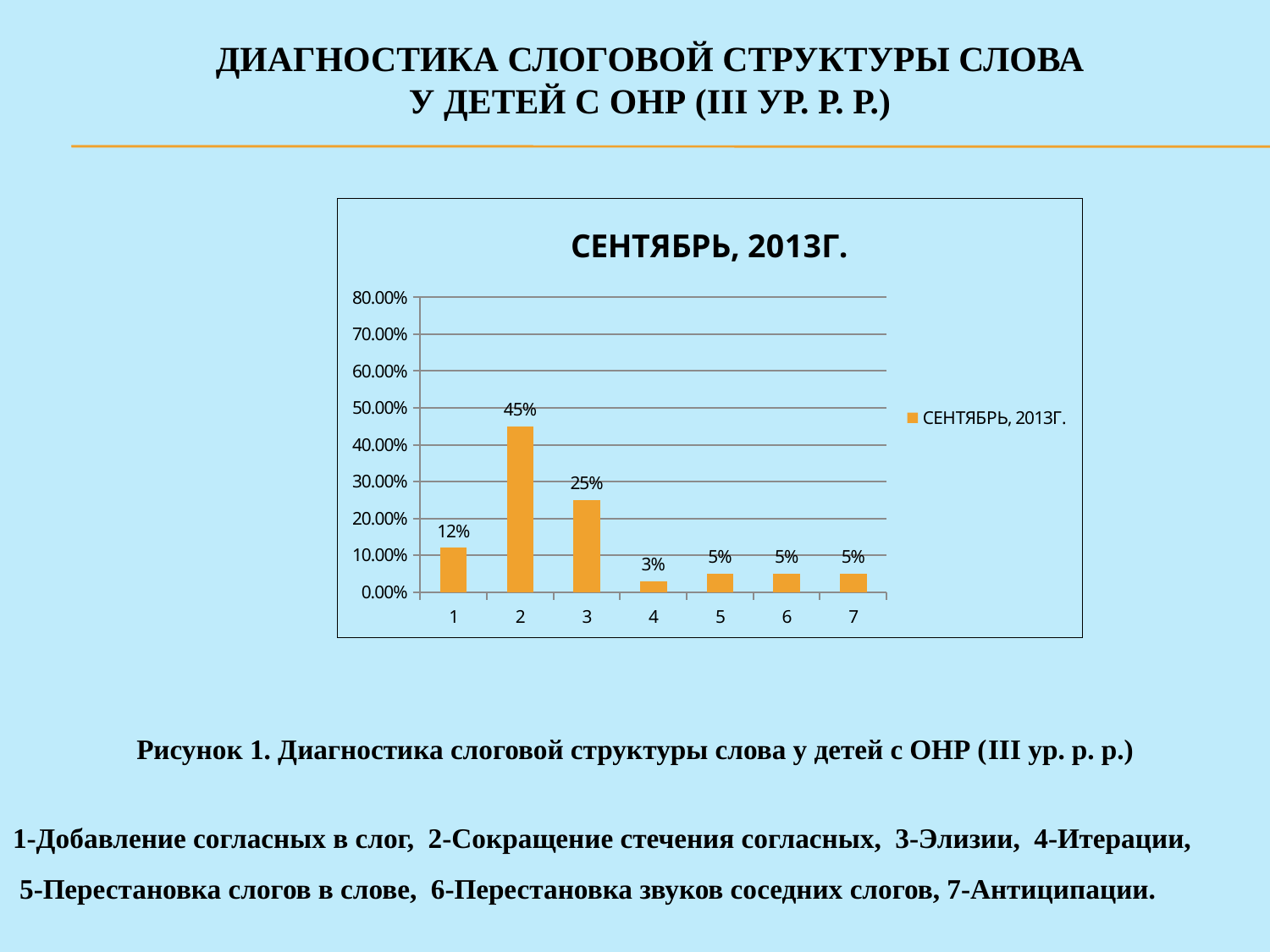
Which category has the highest value? 2 Is the value for category 2 greater or less than 40.00%? greater What is the value for category 2? 45% What is the value for category 4? 3% What is the difference between the values for category 2 and category 3? 20% Which category has the lowest value? 4 What is the value for category 1? 12% How many categories are shown on the x axis? 7 What kind of chart is shown on the slide? bar chart Which is larger, the value for category 1 or the value for category 3? 3 How many series does the legend list? 1 What is the title of the chart? СЕНТЯБРЬ, 2013Г.